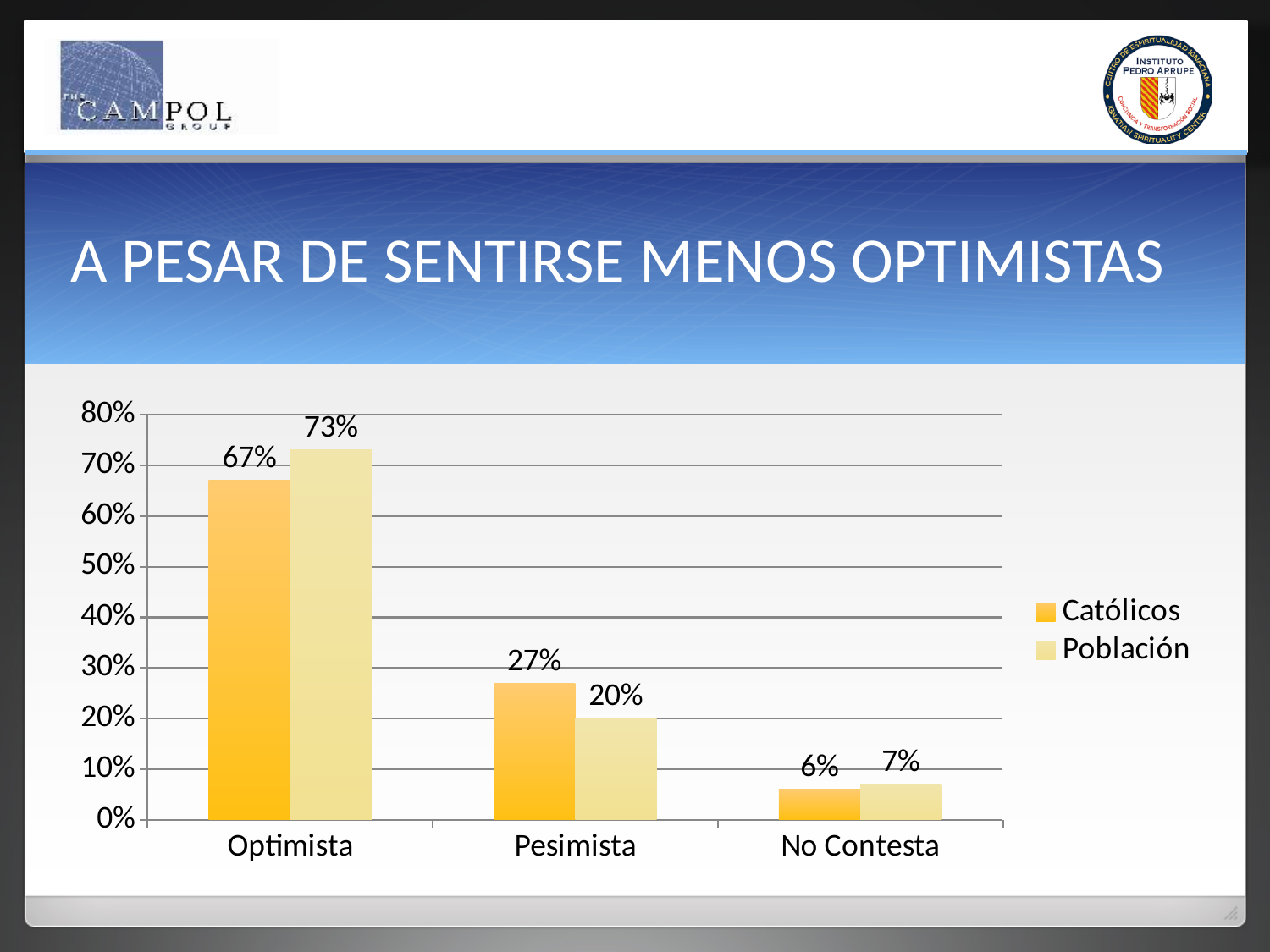
What are the two series named in the legend? Católicos and Población What is the value for Católicos in the Optimista category? 67% In the Pesimista category, which series has the larger value, Católicos or Población? Católicos What is the value for Población in the Pesimista category? 20% What is the value for Católicos in the No Contesta category? 6% Which category has the lowest value for Católicos? No Contesta How many series does the legend list? 2 Which category has the highest value for Población? Optimista What is the difference between Católicos and Población in the Pesimista category? 7% How many categories are shown on the x axis? 3 What is the difference between Población and Católicos in the Optimista category? 6% What kind of chart is shown on the slide? Bar chart